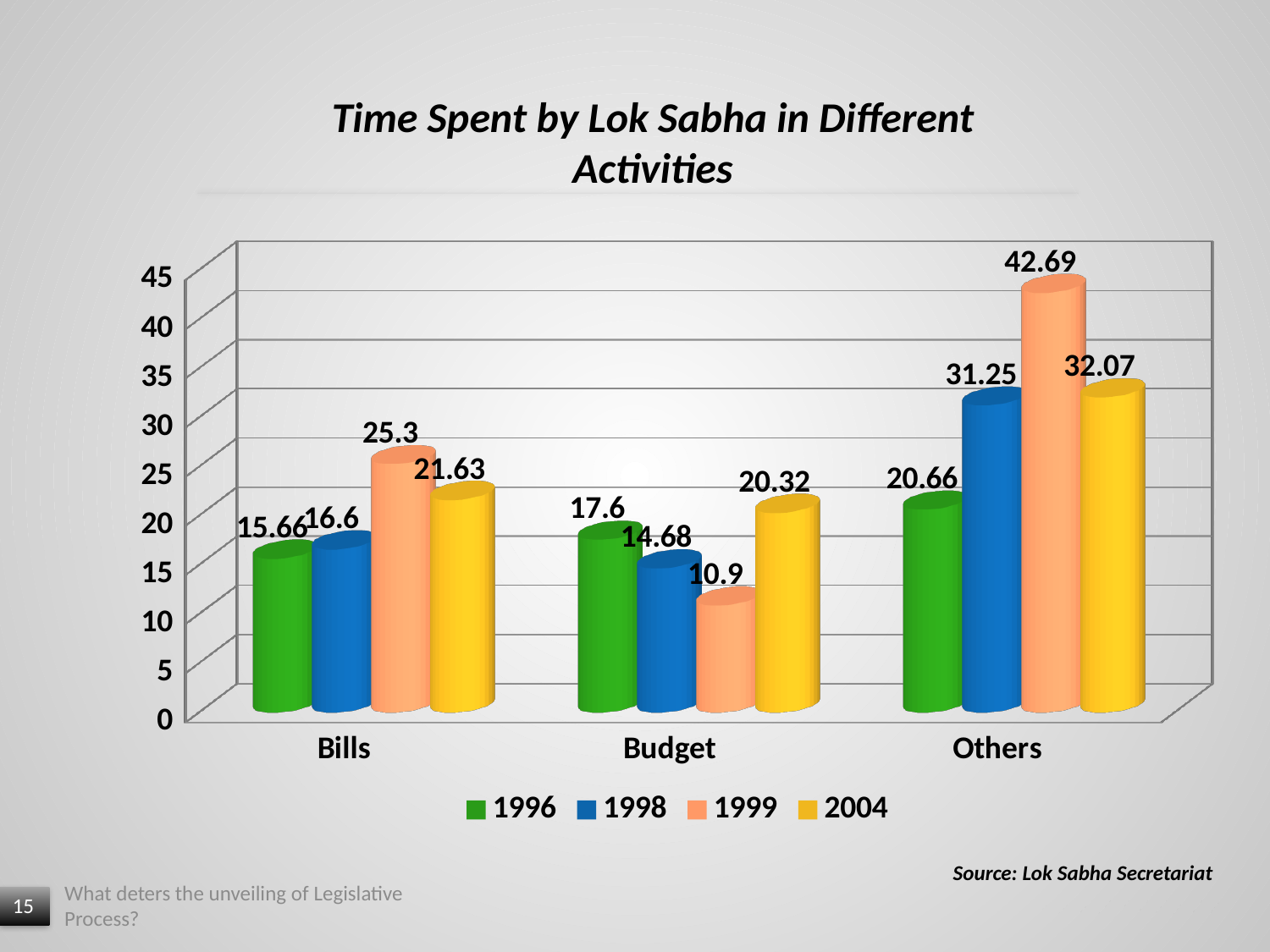
Which is larger in the Bills category: the value for 1996 or the value for 2004? 2004 What is the difference between the 1999 and 2004 values in the Others category? 10.62 What is the source cited for the chart? Lok Sabha Secretariat How many categories are shown on the x axis? 3 What kind of chart is shown on the slide? Bar chart What is the value for 1996 in the Others category? 20.66 How many series does the legend list? 4 Which year has the highest value in the Others category? 1999 What is the value for 1999 in the Bills category? 25.3 Which year has the lowest value in the Budget category? 1999 What is the value for 2004 in the Budget category? 20.32 What is the title of the chart? Time Spent by Lok Sabha in Different Activities